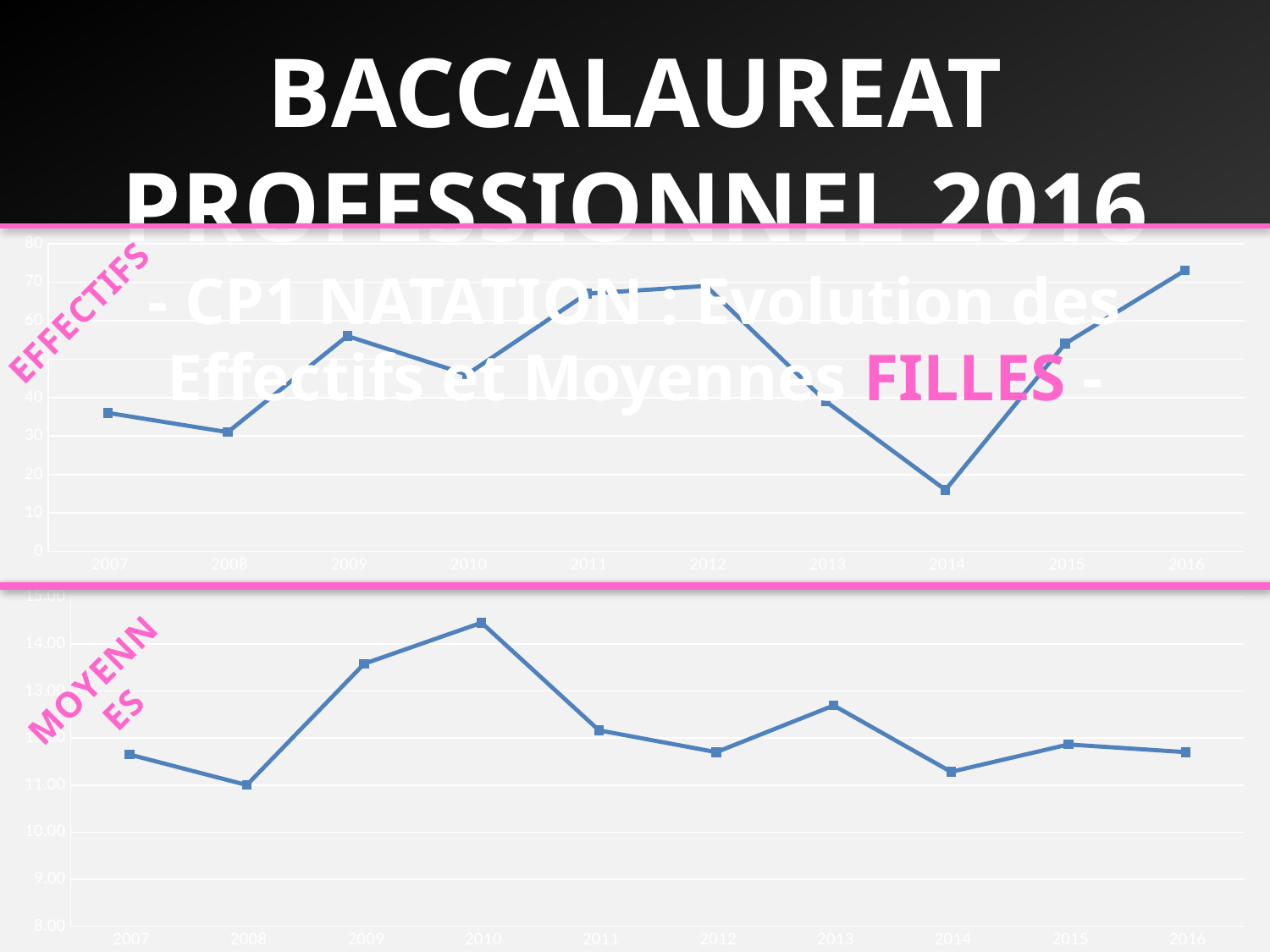
In the bottom chart (MOYENNES), which is larger, the value for 2009 or the value for 2011? 2009 In the top chart (EFFECTIFS), which year has the highest value? 2016 In the top chart (EFFECTIFS), which year has the lowest value? 2014 In the top chart (EFFECTIFS), is the value for 2016 greater or less than 70? greater In the top chart (EFFECTIFS), which is larger, the value for 2009 or the value for 2010? 2009 In the top chart (EFFECTIFS), does the value rise or fall from 2013 to 2014? fall What is the label written in pink on the left of the top chart? EFFECTIFS In the top chart (EFFECTIFS), is the value for 2014 greater or less than 20? less In the bottom chart (MOYENNES), is the value for 2010 greater or less than 14.00? greater How many years are plotted on the x axis of the bottom chart (MOYENNES)? 10 In the bottom chart (MOYENNES), which year has the highest value? 2010 What kind of chart is the top chart (EFFECTIFS)? line chart